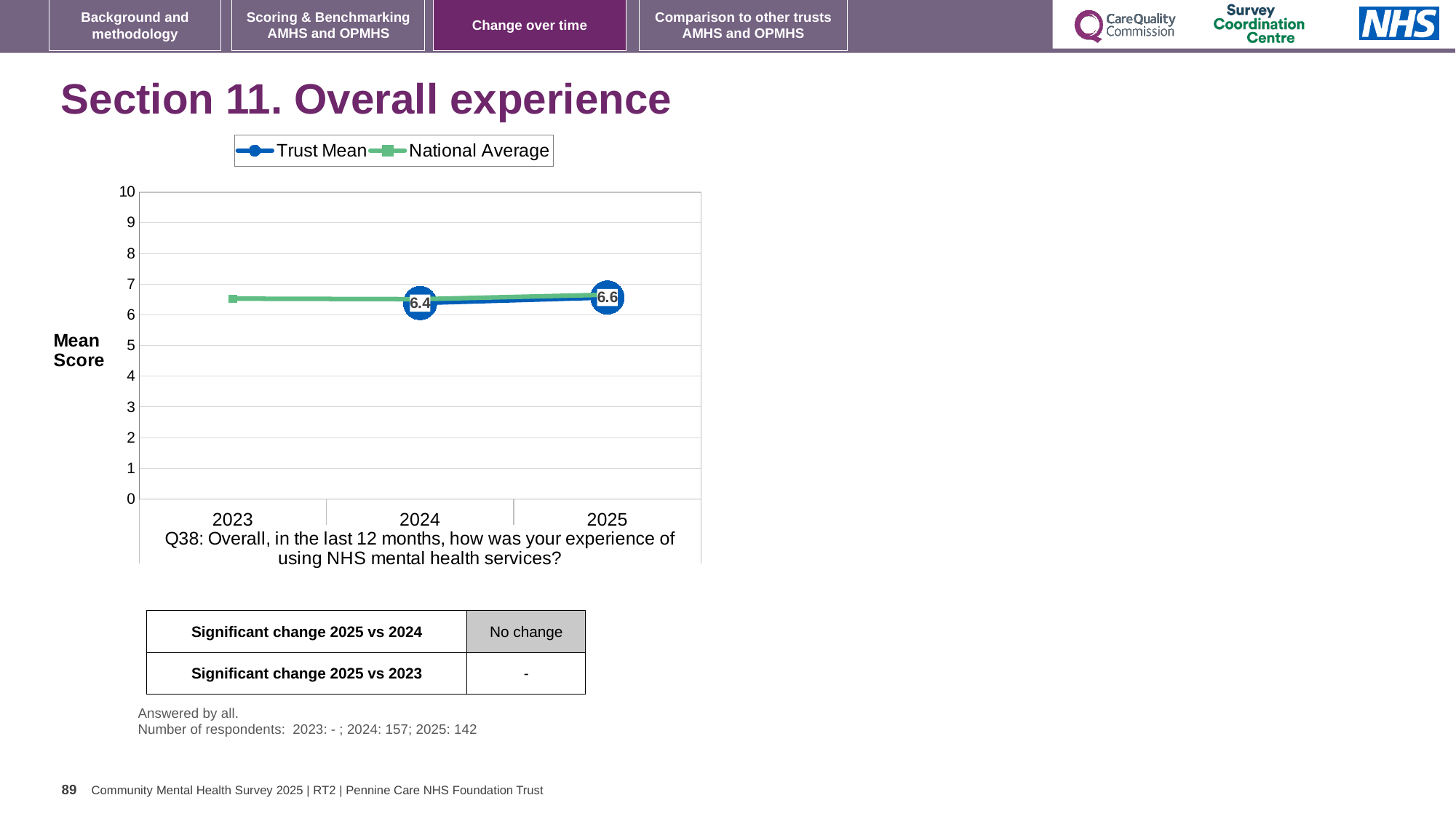
Which year has the higher Trust Mean value, 2024 or 2025? 2025 In which year is the Trust Mean highest? 2025 Is the Trust Mean value for 2024 greater or less than 7? less What is the label on the y axis of the chart? Mean Score How many series does the legend list? 2 Is the National Average value for 2023 greater or less than 5? greater What kind of chart is shown on the slide? line chart What is the difference between the Trust Mean values for 2025 and 2024? 0.2 How many years are shown on the x axis? 3 Does the Trust Mean rise or fall from 2024 to 2025? rise What is the Trust Mean value for 2025? 6.6 What is the Trust Mean value for 2024? 6.4